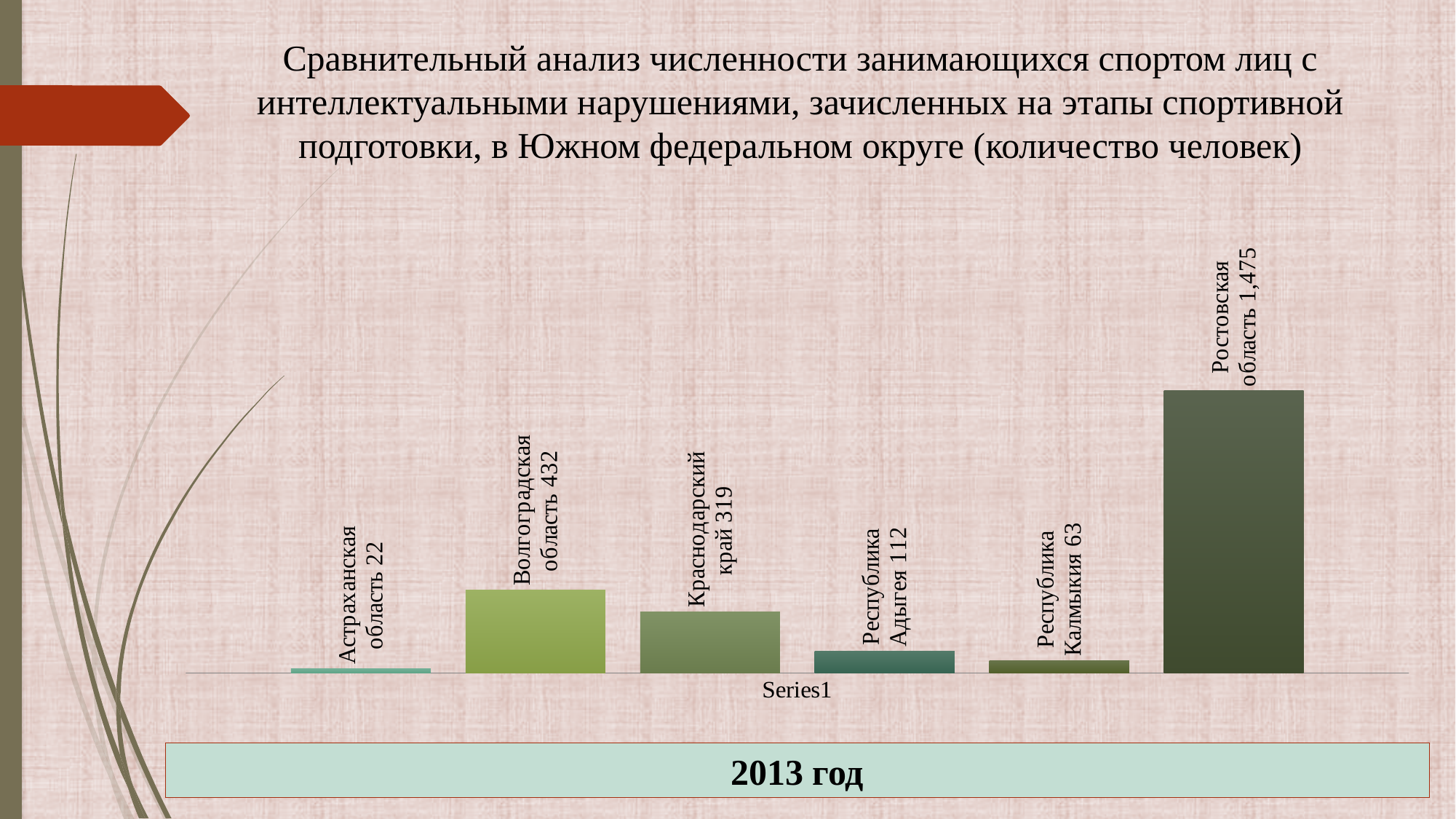
What is the difference between the values for Волгоградская область and Краснодарский край? 113 What is the value for Республика Адыгея? 112 Which region has the lowest value? Астраханская область Which is larger, the value for Республика Адыгея or Республика Калмыкия? Республика Адыгея What kind of chart is shown on the slide? Bar chart What is the value for Волгоградская область? 432 What is the value for Краснодарский край? 319 Which region has the highest value? Ростовская область What year is indicated in the box below the chart? 2013 год How many regions are shown in the chart? 6 What is the value for Астраханская область? 22 What is the value for Ростовская область? 1,475